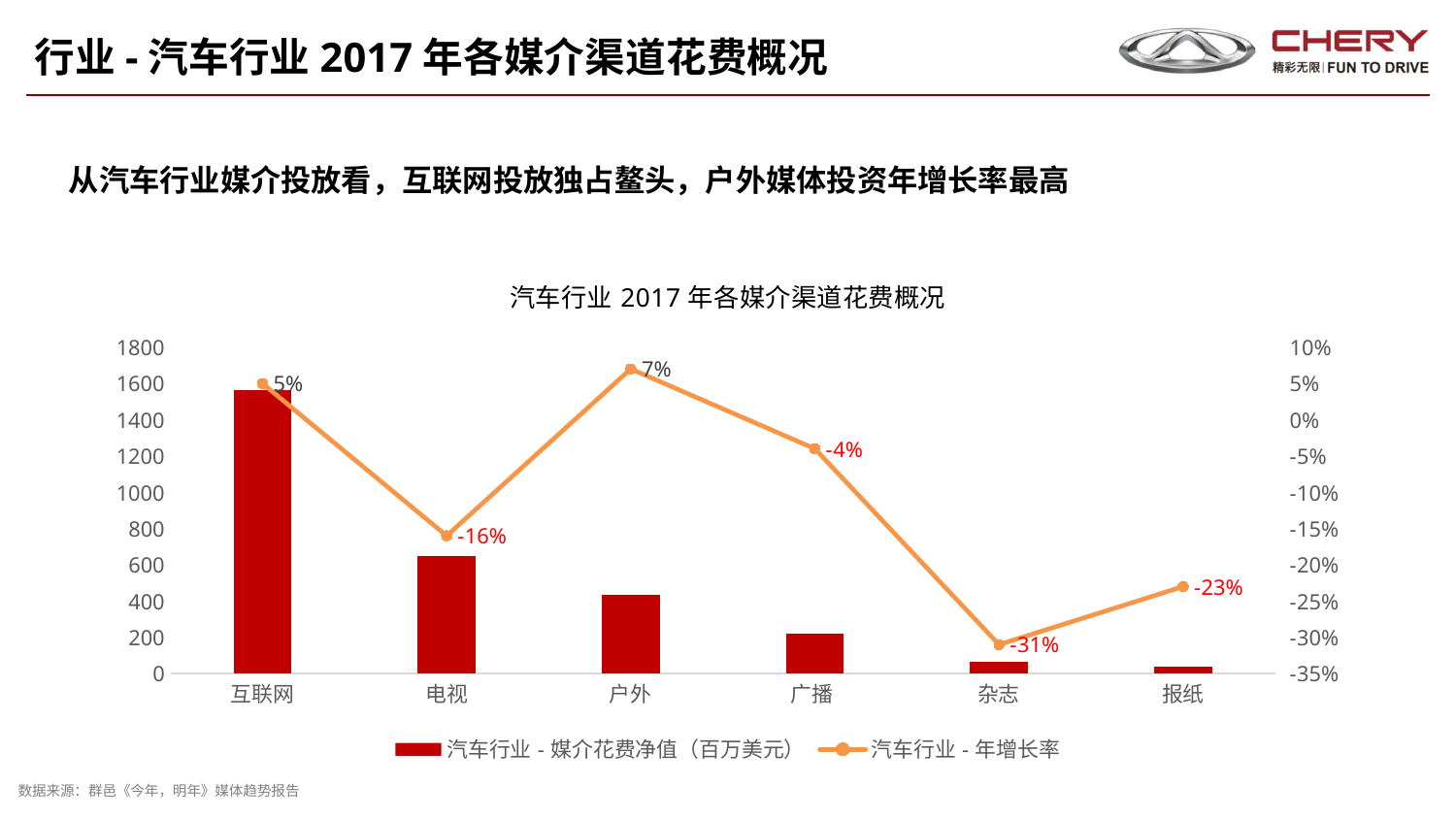
Which media channel has the highest media spend (媒介花费净值)? 互联网 Which media channel has the highest year-on-year growth rate? 户外 How many series does the legend list? 2 Is the media spend value for 电视 greater or less than 800? less What kind of chart is this? Combined bar and line chart What is the year-on-year growth rate (年增长率) for 杂志? -31% Is the media spend value for 互联网 greater or less than 1400? greater What is the year-on-year growth rate (年增长率) for 电视? -16% Which media channel has the lowest year-on-year growth rate? 杂志 What is the difference between the growth rate of 户外 and the growth rate of 互联网? 2 percentage points How many media channels are shown on the x axis? 6 What is the year-on-year growth rate (年增长率) for 户外? 7%